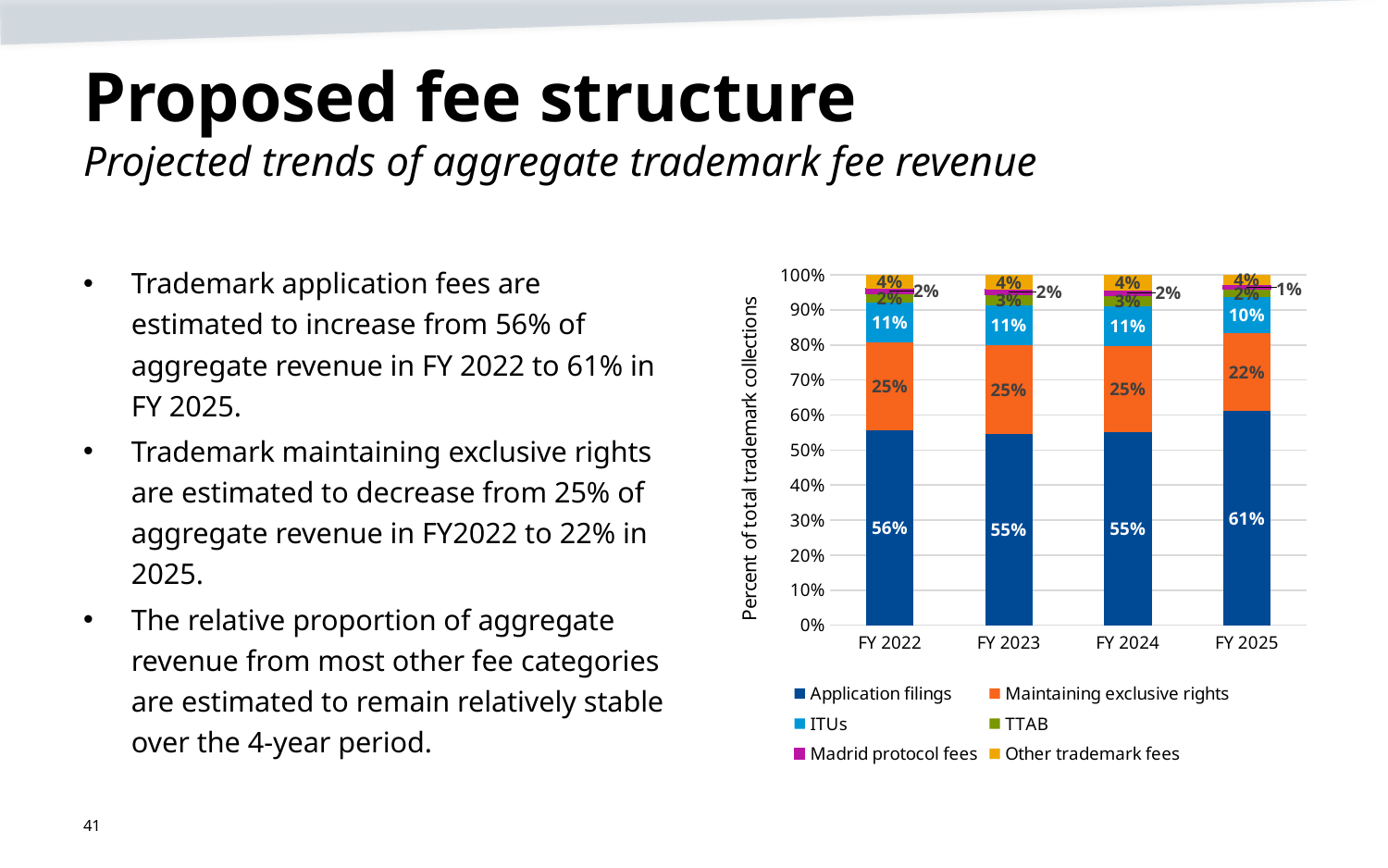
What is the label of the y axis of the chart? Percent of total trademark collections What is the value for Maintaining exclusive rights in FY 2022? 25% What is the value for Other trademark fees in FY 2023? 4% What is the value for Madrid protocol fees in FY 2025? 1% How many fiscal years are shown on the x axis of the chart? 4 What is the value for Application filings in FY 2025? 61% What type of chart is shown on the slide? Stacked bar chart In which fiscal year is the Application filings share highest? FY 2025 How many series does the chart legend list? 6 What is the difference between the Application filings share in FY 2025 and in FY 2022? 5% What is the value for ITUs in FY 2025? 10% Which is larger: the Maintaining exclusive rights share in FY 2024 or in FY 2025? FY 2024